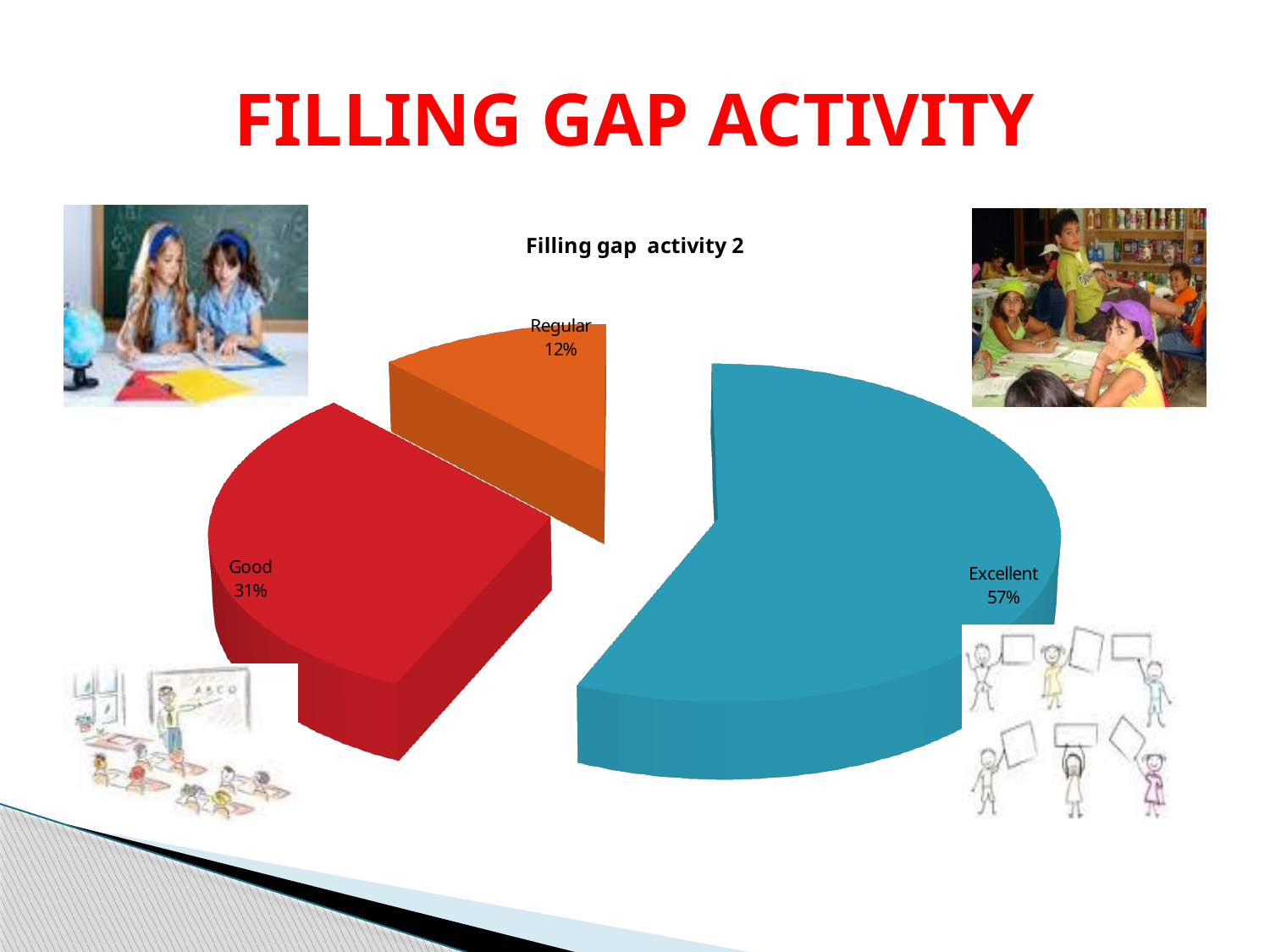
What type of chart is shown on the slide? Pie chart Which category has the largest share of the pie? Excellent How many slices does the pie chart have? 3 Which slice is larger, Good or Regular? Good What is the difference in percentage points between the Excellent and Good slices? 26 What is the difference in percentage points between the Good and Regular slices? 19 Which category has the smallest share of the pie? Regular What is the title of the chart? Filling gap activity 2 What percentage of the pie is labelled Regular? 12% What percentage of the pie is labelled Good? 31% What colour is the Excellent slice? Blue What percentage of the pie is labelled Excellent? 57%